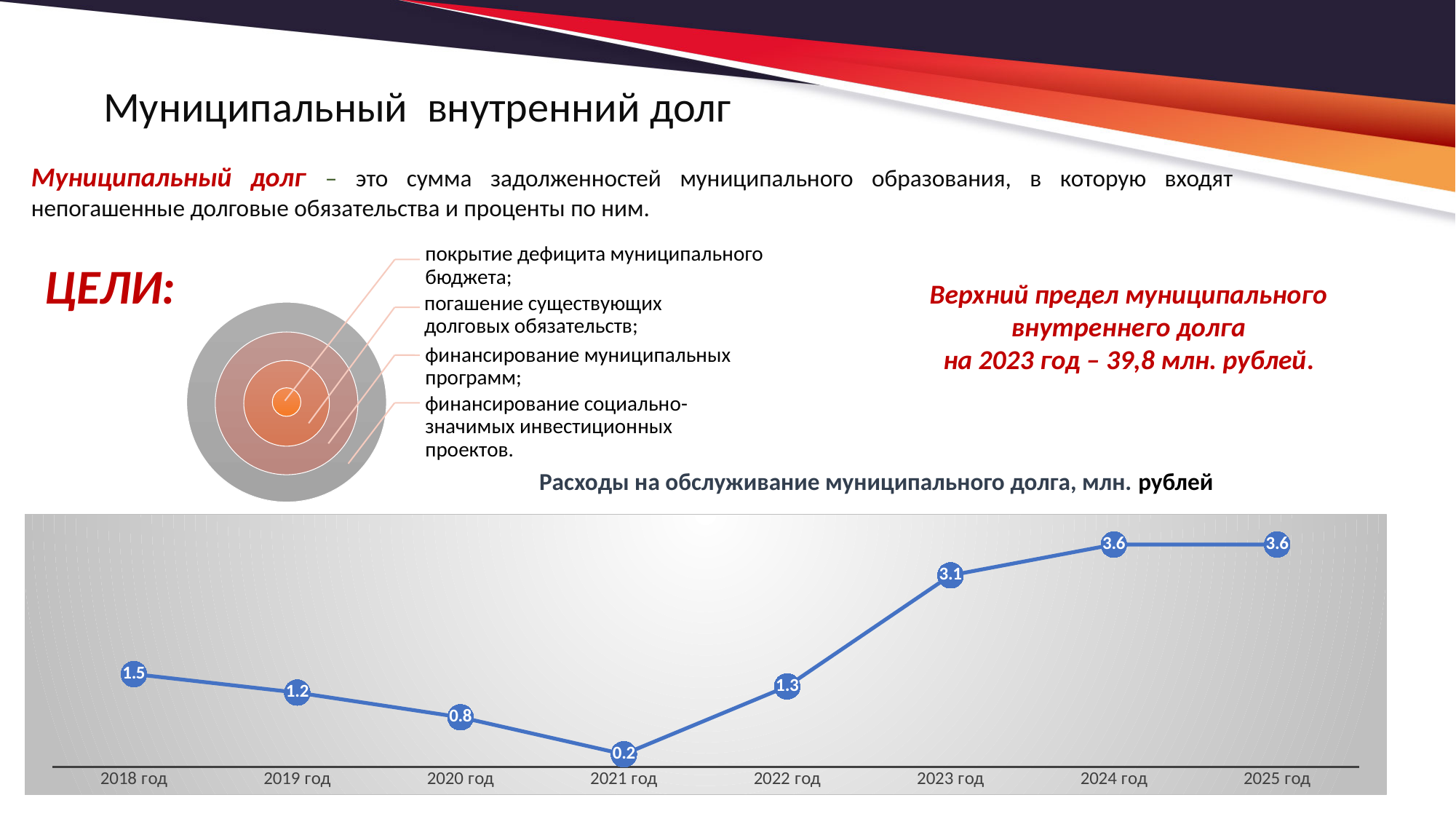
What is the value for 2021 год in the chart 'Расходы на обслуживание муниципального долга, млн. рублей'? 0.2 How many years are plotted in the chart 'Расходы на обслуживание муниципального долга, млн. рублей'? 8 What is the value for 2025 год in the chart 'Расходы на обслуживание муниципального долга, млн. рублей'? 3.6 What is the difference between the values for 2023 год and 2022 год in the chart 'Расходы на обслуживание муниципального долга, млн. рублей'? 1.8 What kind of chart is 'Расходы на обслуживание муниципального долга, млн. рублей'? line chart What is the value for 2018 год in the chart 'Расходы на обслуживание муниципального долга, млн. рублей'? 1.5 What is the value for 2023 год in the chart 'Расходы на обслуживание муниципального долга, млн. рублей'? 3.1 Which is larger in the chart 'Расходы на обслуживание муниципального долга, млн. рублей': the value for 2019 год or the value for 2022 год? 2022 год Do the values in the chart 'Расходы на обслуживание муниципального долга, млн. рублей' rise or fall from 2018 год to 2021 год? fall What is the title of the line chart on the slide? Расходы на обслуживание муниципального долга, млн. рублей What is the difference between the values for 2018 год and 2020 год in the chart 'Расходы на обслуживание муниципального долга, млн. рублей'? 0.7 Which year has the lowest value in the chart 'Расходы на обслуживание муниципального долга, млн. рублей'? 2021 год